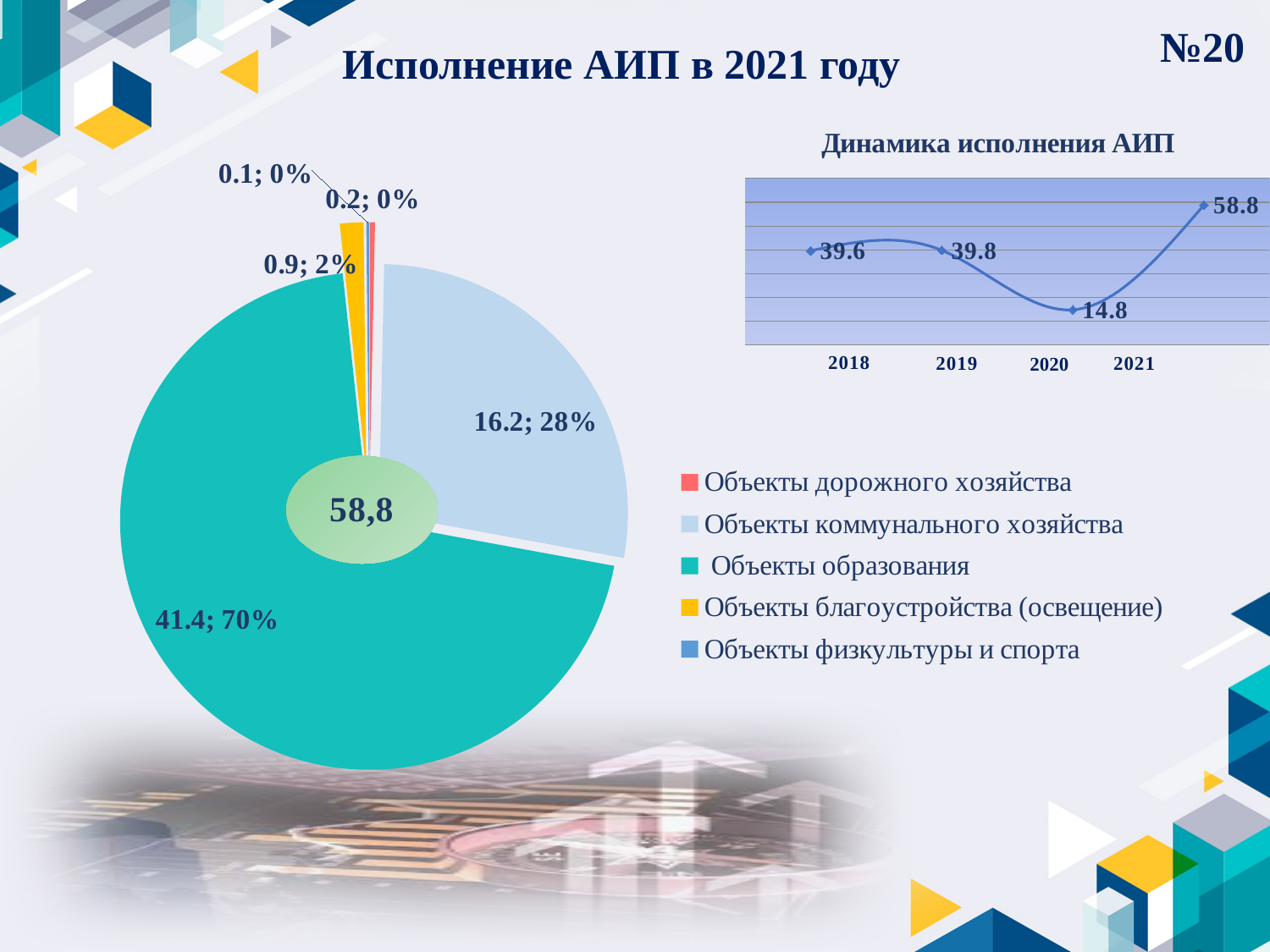
In the line chart 'Динамика исполнения АИП', what is the difference between the 2021 value and the 2020 value? 44.0 In the pie chart on the left, which category has the largest slice? Объекты образования In the line chart 'Динамика исполнения АИП', what is the value for 2020? 14.8 How many years are plotted in the line chart 'Динамика исполнения АИП'? 4 How many categories does the legend of the pie chart on the left list? 5 In the line chart 'Динамика исполнения АИП', what is the value for 2021? 58.8 What kind of chart is the chart titled 'Динамика исполнения АИП'? line chart In the pie chart on the left, what share does 'Объекты образования' have? 70% In the pie chart on the left, what is the value shown for 'Объекты коммунального хозяйства'? 16.2 In the pie chart on the left, which is larger: 'Объекты образования' or 'Объекты коммунального хозяйства'? Объекты образования In the line chart 'Динамика исполнения АИП', which year has the lowest value? 2020 In the line chart 'Динамика исполнения АИП', which year has the highest value? 2021